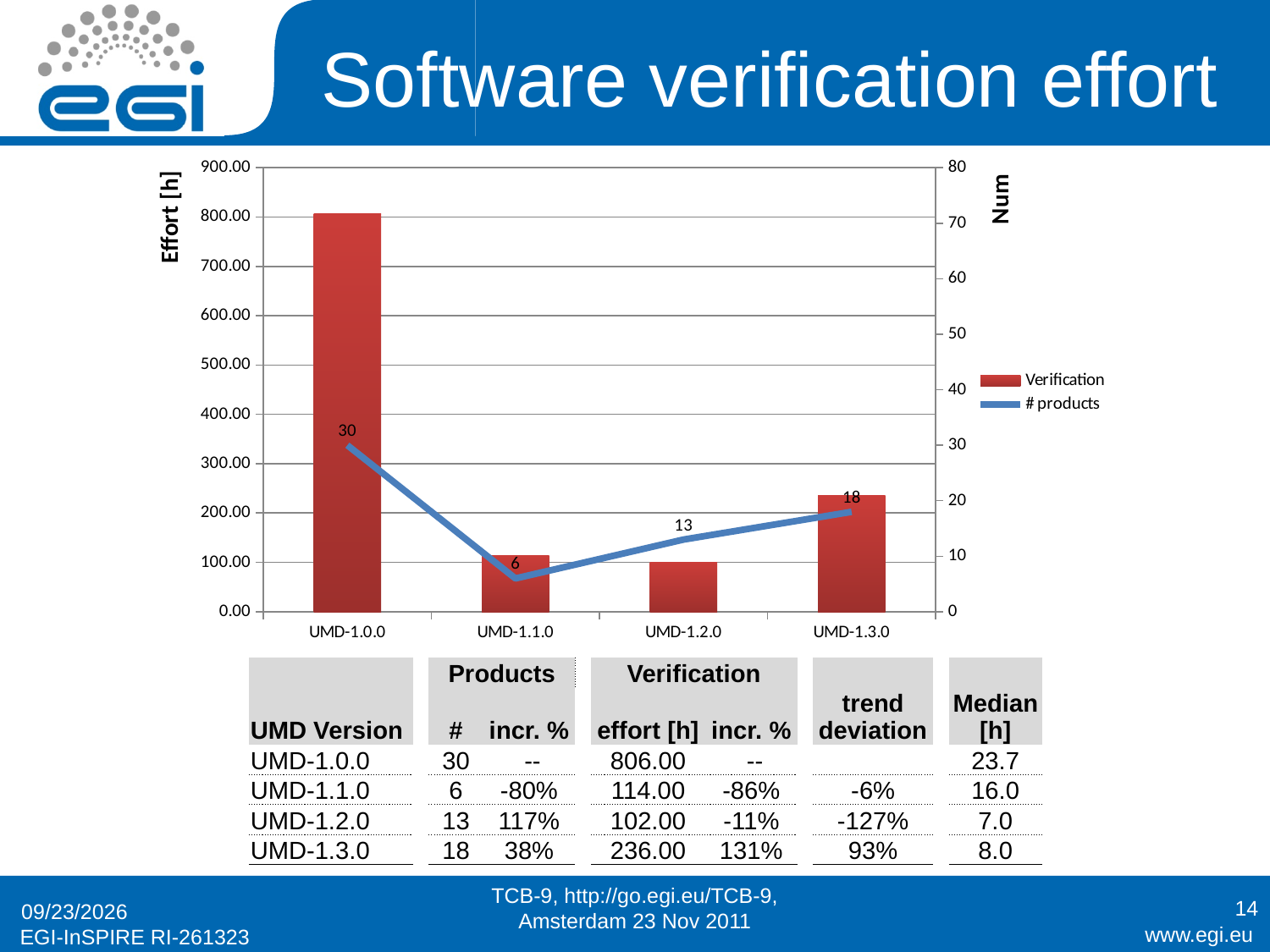
Is the Verification effort bar for UMD-1.0.0 greater or less than 700? greater How many UMD versions are shown on the x axis of the chart? 4 What is the # products value for UMD-1.1.0? 6 Which UMD version has the lowest # products value? UMD-1.1.0 Which has the larger Verification effort bar, UMD-1.3.0 or UMD-1.1.0? UMD-1.3.0 Which UMD version has the highest # products value? UMD-1.0.0 What is the # products value for UMD-1.2.0? 13 What kind of chart is shown on the slide? A bar chart combined with a line series What is the difference between the # products values for UMD-1.0.0 and UMD-1.3.0? 12 Is the Verification effort bar for UMD-1.2.0 greater or less than 200? less What is the # products value for UMD-1.0.0? 30 How many series does the chart legend list? 2